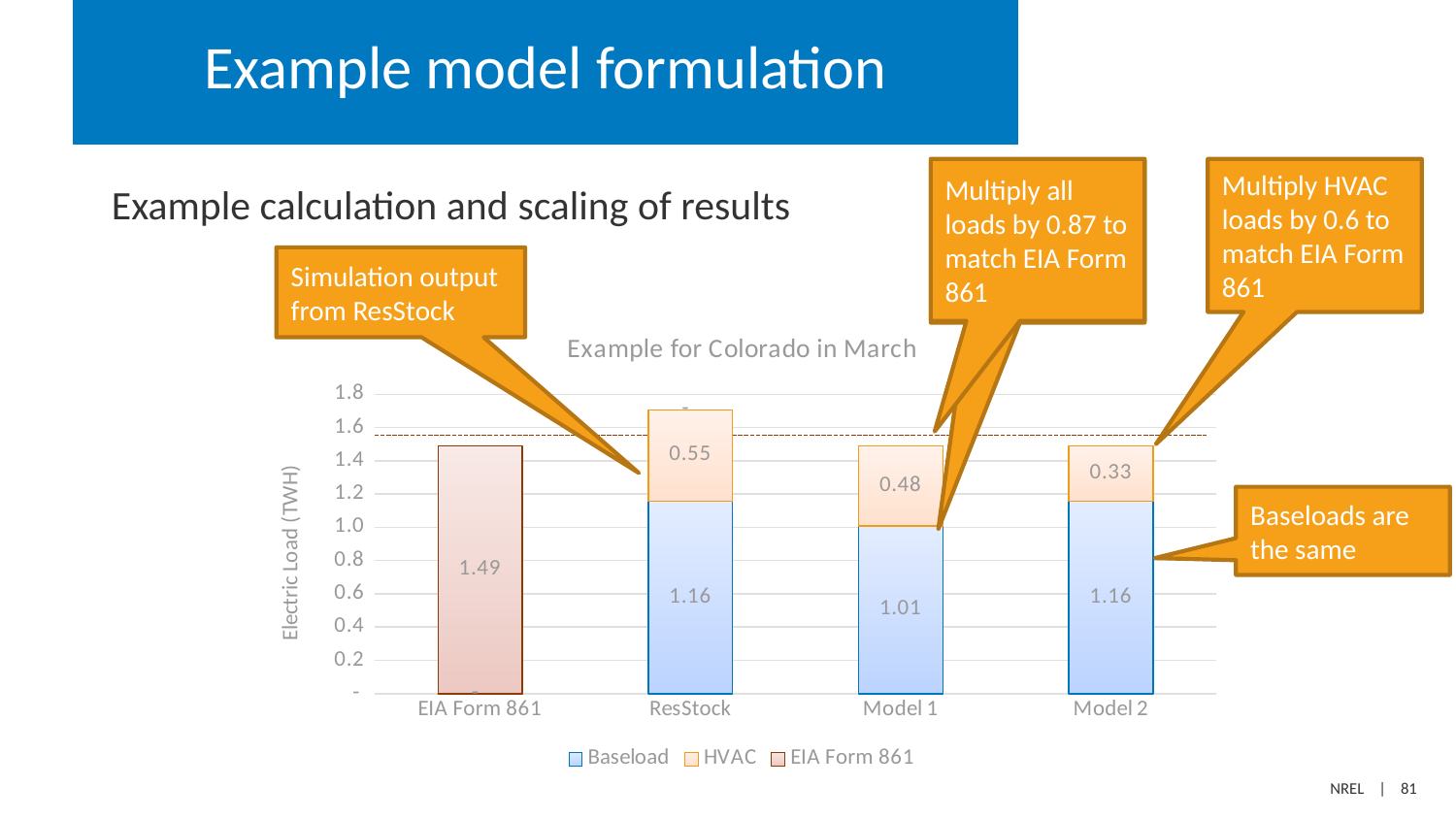
How many categories are shown on the x axis? 4 How many series does the legend list? 3 Which category has the lowest Baseload value? Model 1 What is the difference between the HVAC values for ResStock and Model 2? 0.22 What is the total of the stacked bar for ResStock? 1.71 What is the Baseload value for ResStock? 1.16 What is the total of the stacked bar for Model 1? 1.49 What is the HVAC value for Model 1? 0.48 Which category has the highest HVAC value? ResStock Is the Baseload value for Model 1 larger or smaller than the Baseload value for Model 2? smaller What is the HVAC value for Model 2? 0.33 What is the value shown for the EIA Form 861 bar? 1.49